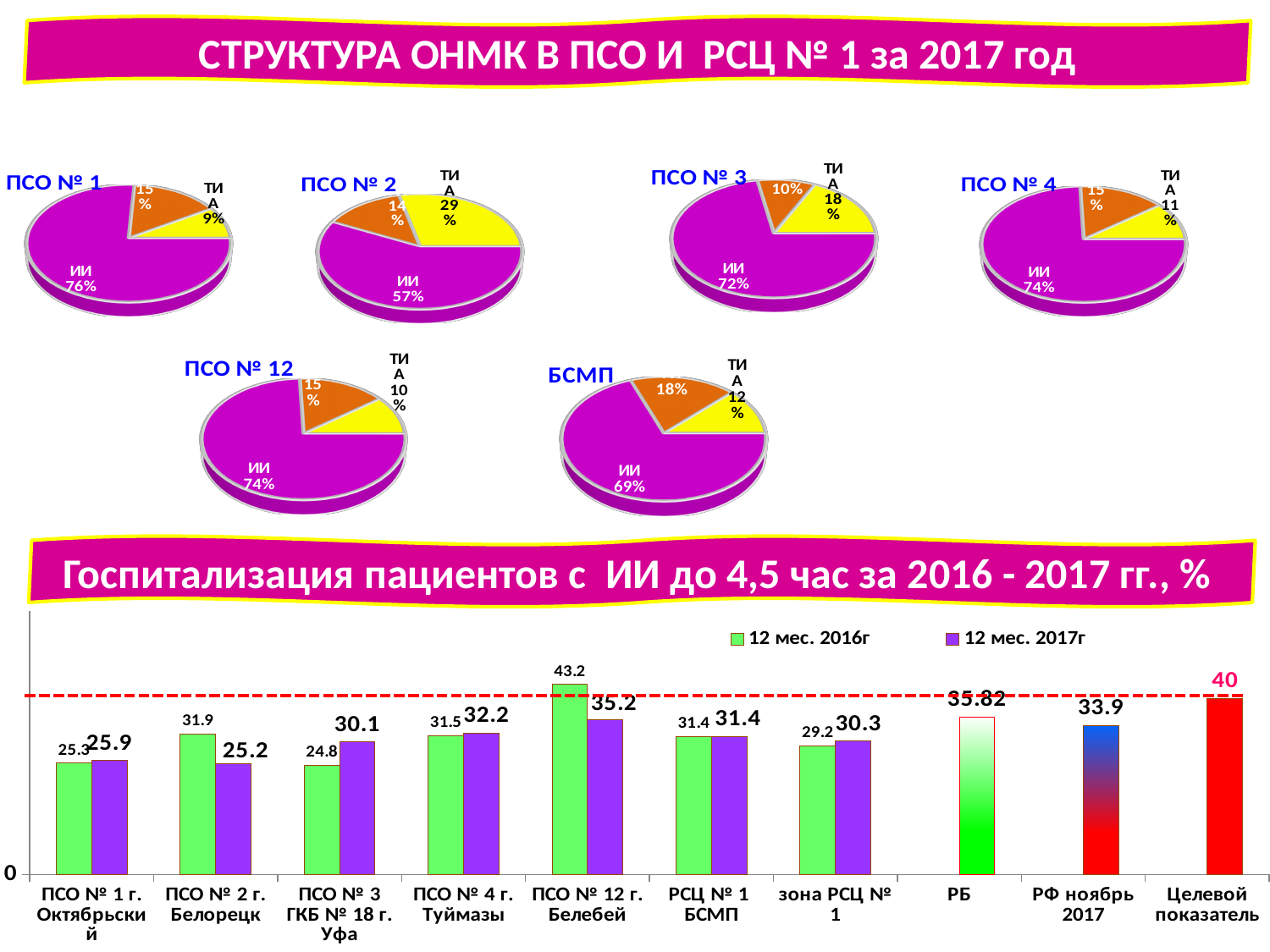
In the bar chart 'Госпитализация пациентов с ИИ до 4,5 час за 2016 - 2017 гг., %', what is the difference between the 12 мес. 2016г and 12 мес. 2017г values for ПСО № 12 г. Белебей? 8.0 In the ПСО № 2 pie chart, what share is ИИ? 57% In the bar chart 'Госпитализация пациентов с ИИ до 4,5 час за 2016 - 2017 гг., %', which category has the lowest 12 мес. 2017г value? ПСО № 2 г. Белорецк In the bar chart 'Госпитализация пациентов с ИИ до 4,5 час за 2016 - 2017 гг., %', what is the value for РБ? 35.82 In the bar chart 'Госпитализация пациентов с ИИ до 4,5 час за 2016 - 2017 гг., %', what is the value for ПСО № 3 ГКБ № 18 г. Уфа for 12 мес. 2017г? 30.1 Among the six pie charts, which one has the largest ТИА share? ПСО № 2 In the БСМП pie chart, what share is ИИ? 69% How many series does the legend of the bar chart 'Госпитализация пациентов с ИИ до 4,5 час за 2016 - 2017 гг., %' list? 2 How many pie charts are shown on the slide? 6 In the bar chart 'Госпитализация пациентов с ИИ до 4,5 час за 2016 - 2017 гг., %', which is larger for ПСО № 2 г. Белорецк: the 12 мес. 2016г value or the 12 мес. 2017г value? 12 мес. 2016г In the bar chart 'Госпитализация пациентов с ИИ до 4,5 час за 2016 - 2017 гг., %', what is the value for ПСО № 12 г. Белебей for 12 мес. 2016г? 43.2 In the ПСО № 3 pie chart, what share is ТИА? 18%